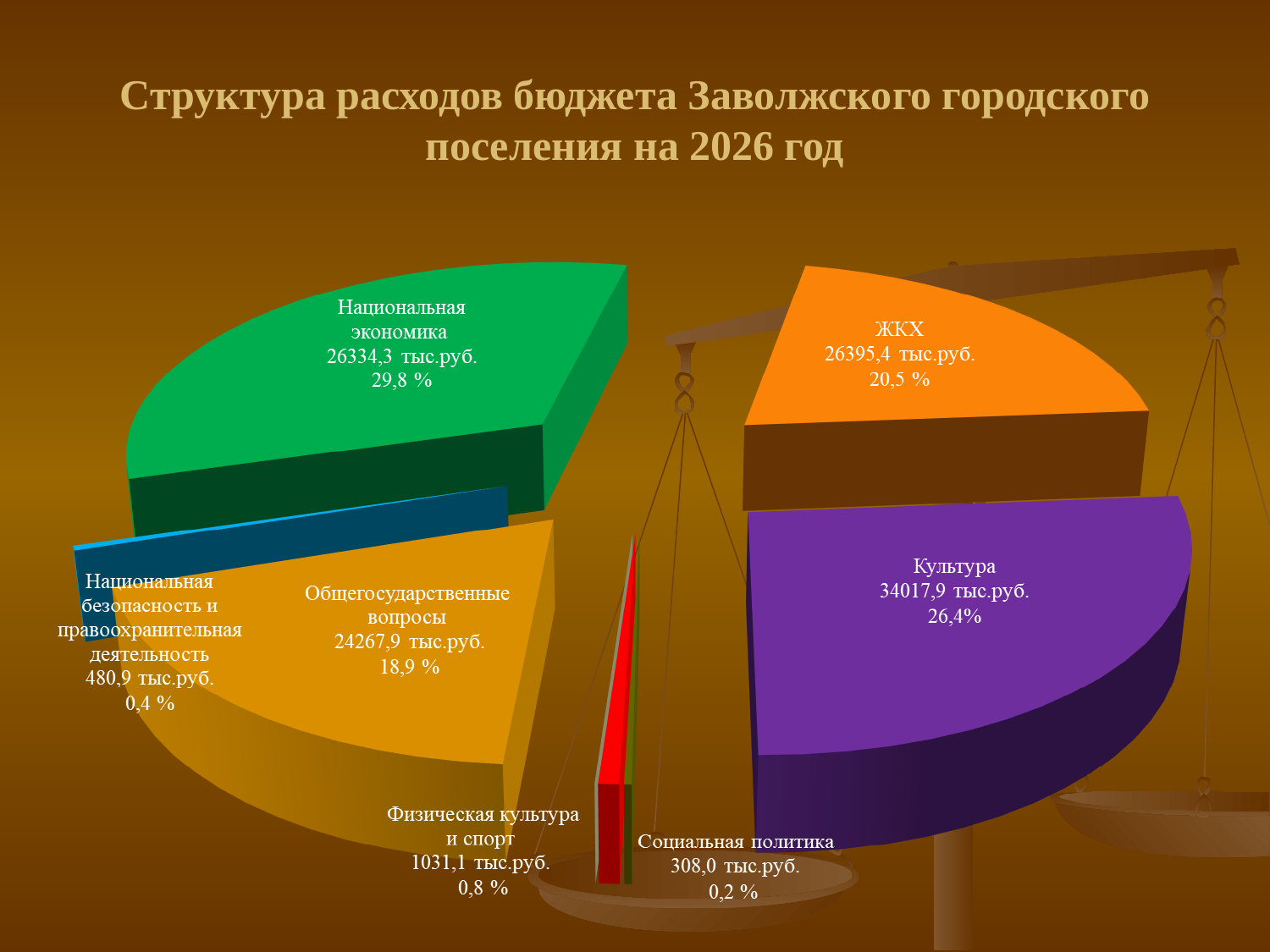
Which is larger in тыс.руб.: Культура or Национальная экономика? Культура Which category has the largest amount in тыс.руб.? Культура What is the amount shown for ЖКХ? 26395,4 тыс.руб. What percentage share is shown for Национальная экономика? 29,8 % What is the title of the chart on the slide? Структура расходов бюджета Заволжского городского поселения на 2026 год What percentage share is shown for Общегосударственные вопросы? 18,9 % What kind of chart is shown on the slide? Pie chart How many slices (expenditure categories) does the pie chart have? 7 What is the difference in тыс.руб. between Культура and Общегосударственные вопросы? 9750,0 тыс.руб. Which category has the smallest amount in тыс.руб.? Социальная политика What is the amount shown for Культура? 34017,9 тыс.руб. What is the difference in тыс.руб. between Физическая культура и спорт and Социальная политика? 723,1 тыс.руб.